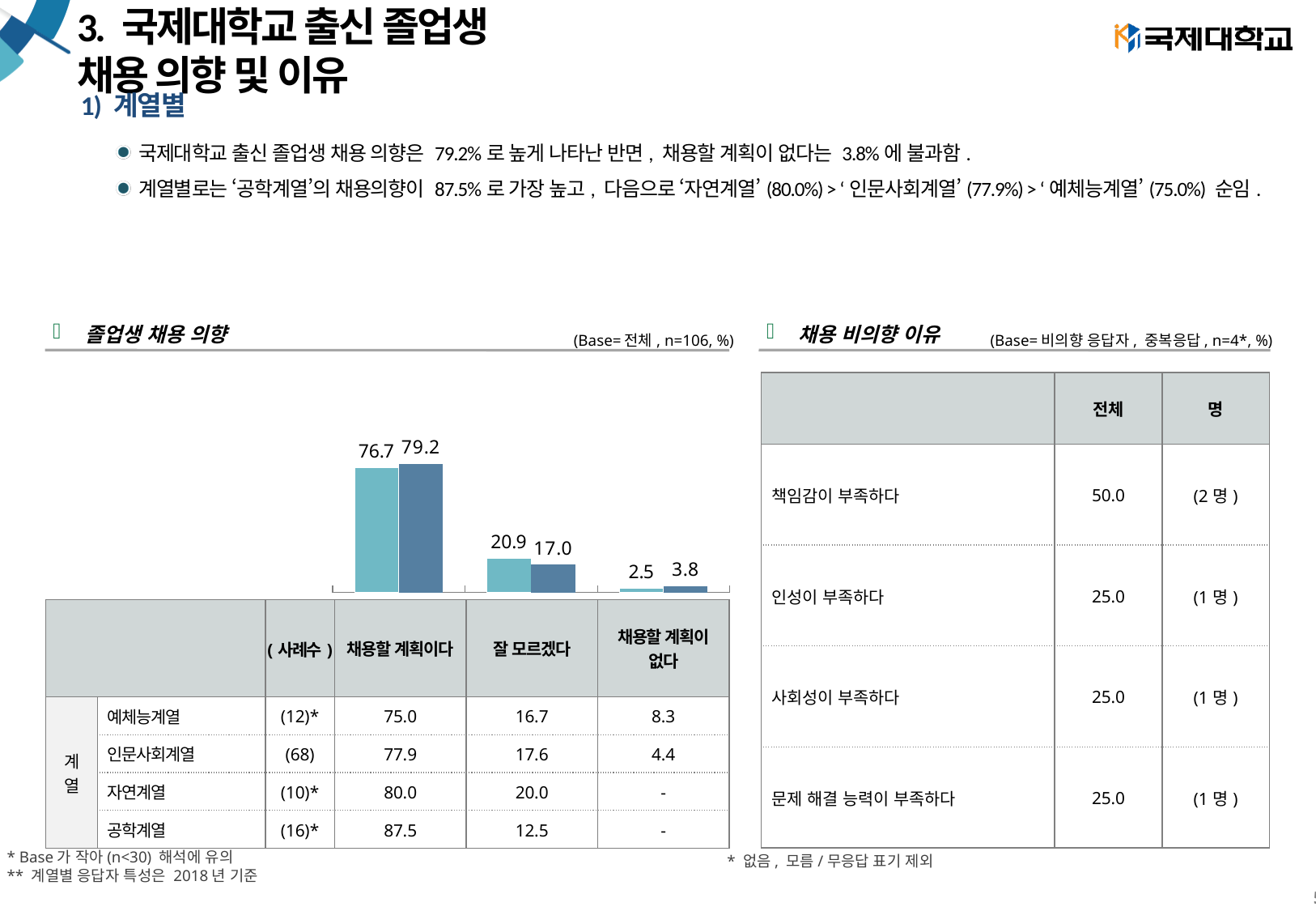
In the '졸업생 채용 의향' chart, what is the value of the dark blue bar for '채용할 계획이 없다'? 3.8 In the '졸업생 채용 의향' chart, what is the difference between the light teal and dark blue bars for '잘 모르겠다'? 3.9 Do the dark blue bar values in the '졸업생 채용 의향' chart rise or fall from left to right? fall In the '졸업생 채용 의향' chart, what is the value of the dark blue bar for '채용할 계획이다'? 79.2 In the '졸업생 채용 의향' chart, what is the value of the light teal bar for '채용할 계획이다'? 76.7 How many categories are plotted in the '졸업생 채용 의향' chart? 3 In the '졸업생 채용 의향' chart, which category has the lowest light teal bar? 채용할 계획이 없다 What kind of chart is shown under the heading '졸업생 채용 의향'? bar chart In the '졸업생 채용 의향' chart, what is the value of the light teal bar for '잘 모르겠다'? 20.9 In the '졸업생 채용 의향' chart, for '잘 모르겠다', which bar is larger: the light teal or the dark blue? light teal In the '졸업생 채용 의향' chart, what is the difference between the dark blue and light teal bars for '채용할 계획이다'? 2.5 In the '졸업생 채용 의향' chart, which category has the highest dark blue bar? 채용할 계획이다